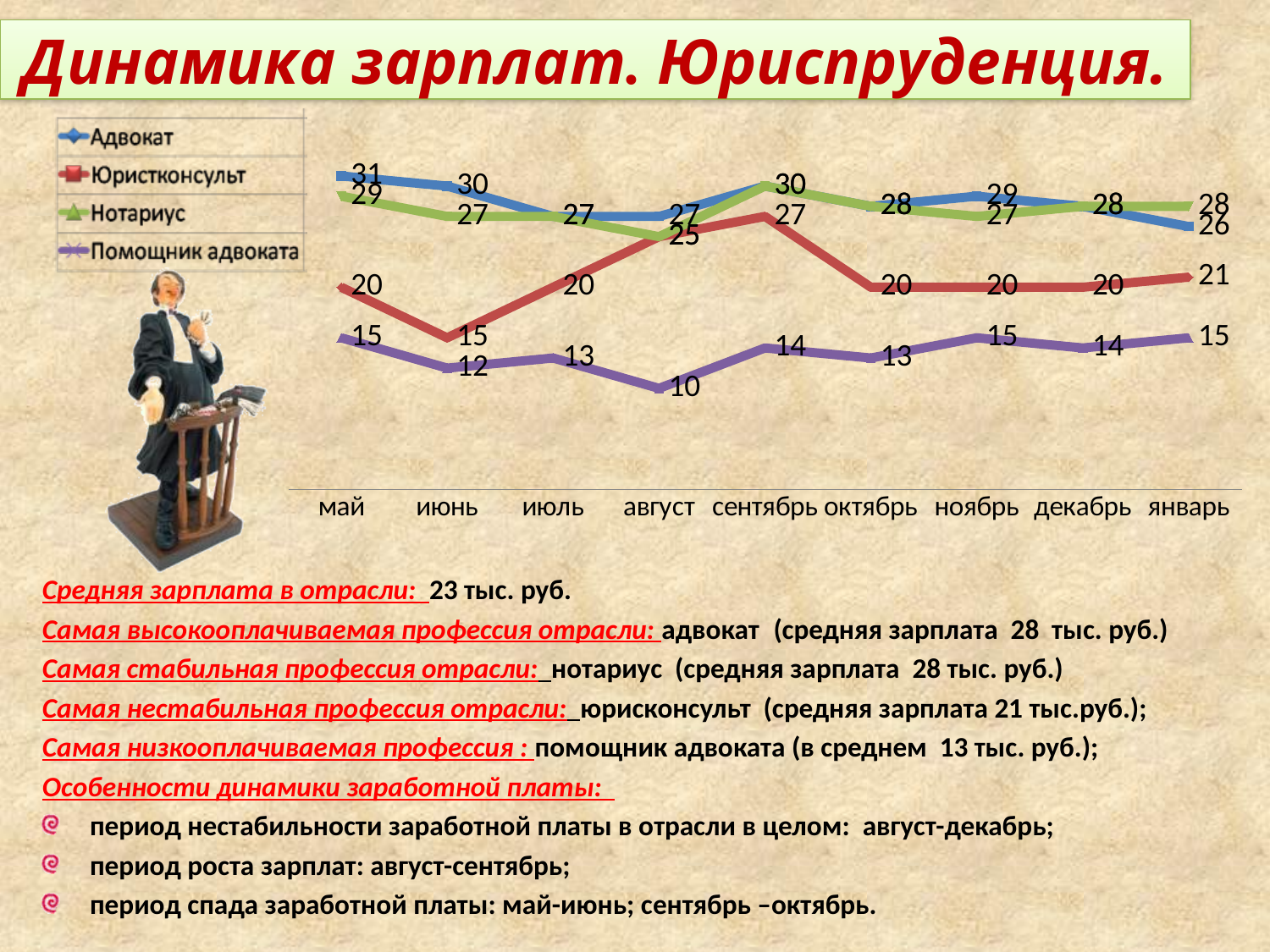
How many series does the legend list? 4 What is the value for Юристконсульт in январь? 21 Does the value for Юристконсульт rise or fall from май to июнь? fall What is the value for Помощник адвоката in август? 10 What is the value for Адвокат in май? 31 What is the difference between Адвокат and Помощник адвоката in май? 16 In январь, which is larger: Нотариус or Адвокат? Нотариус In which month is the value for Помощник адвоката lowest? август How many months are shown on the x axis? 9 What is the value for Юристконсульт in июнь? 15 What kind of chart is shown on the slide? line chart In which month is the value for Юристконсульт lowest? июнь